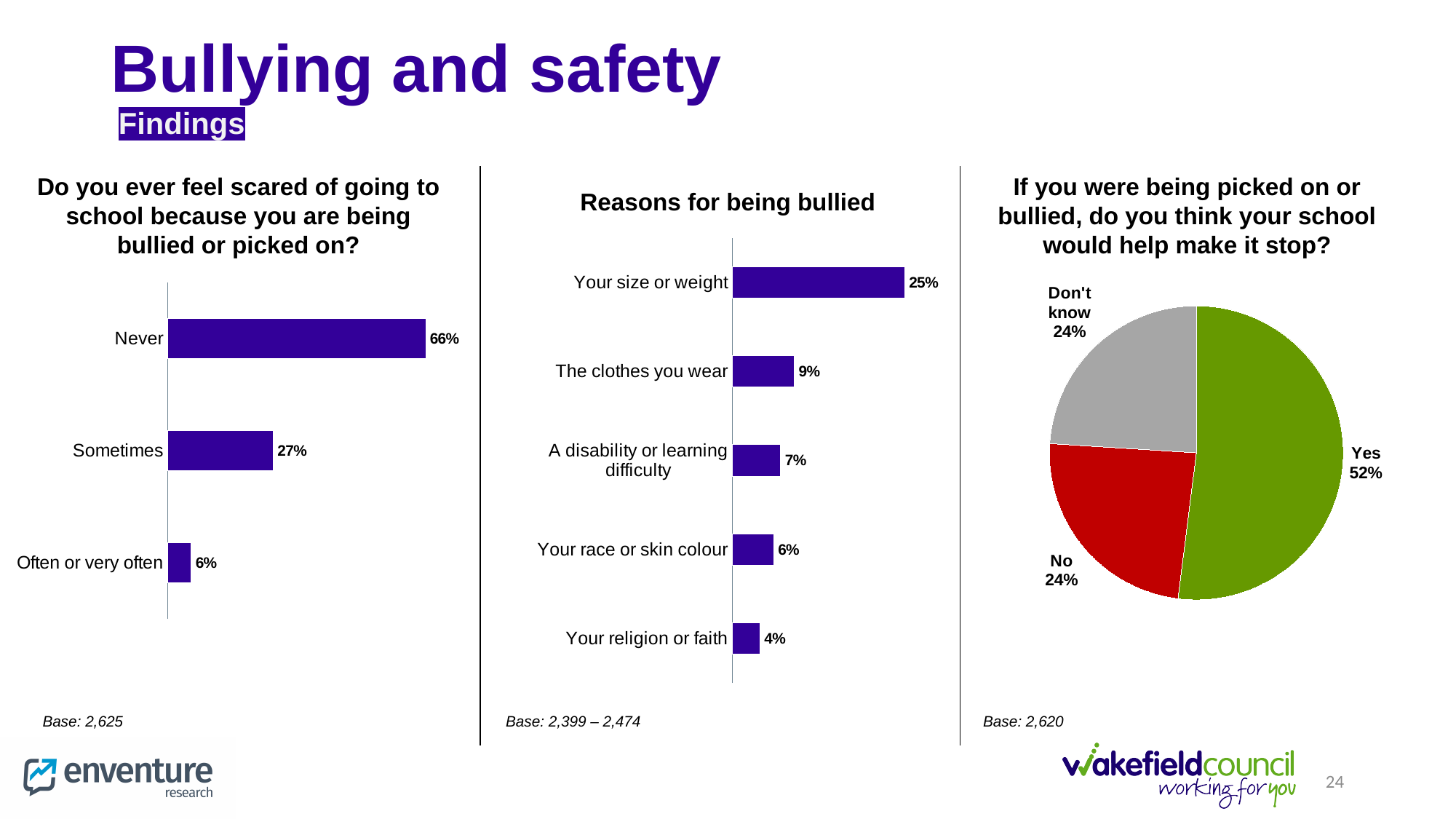
In the pie chart 'If you were being picked on or bullied, do you think your school would help make it stop?', what is the value for 'Don't know'? 24% What kind of chart is 'Reasons for being bullied'? Bar chart In the chart 'Do you ever feel scared of going to school because you are being bullied or picked on?', what is the difference between 'Never' and 'Sometimes'? 39% In the 'Reasons for being bullied' chart, which reason has the highest value? Your size or weight In the chart 'Do you ever feel scared of going to school because you are being bullied or picked on?', which category has the lowest value? Often or very often In the pie chart 'If you were being picked on or bullied, do you think your school would help make it stop?', what share of respondents answered 'Yes'? 52% In the chart 'Do you ever feel scared of going to school because you are being bullied or picked on?', what is the value for 'Never'? 66% In the 'Reasons for being bullied' chart, which is larger: 'A disability or learning difficulty' or 'Your religion or faith'? A disability or learning difficulty In the 'Reasons for being bullied' chart, how many reasons are listed? 5 In the chart 'Do you ever feel scared of going to school because you are being bullied or picked on?', how many categories are shown? 3 In the pie chart 'If you were being picked on or bullied, do you think your school would help make it stop?', what colour is the 'No' slice? Red In the 'Reasons for being bullied' chart, what is the value for 'The clothes you wear'? 9%